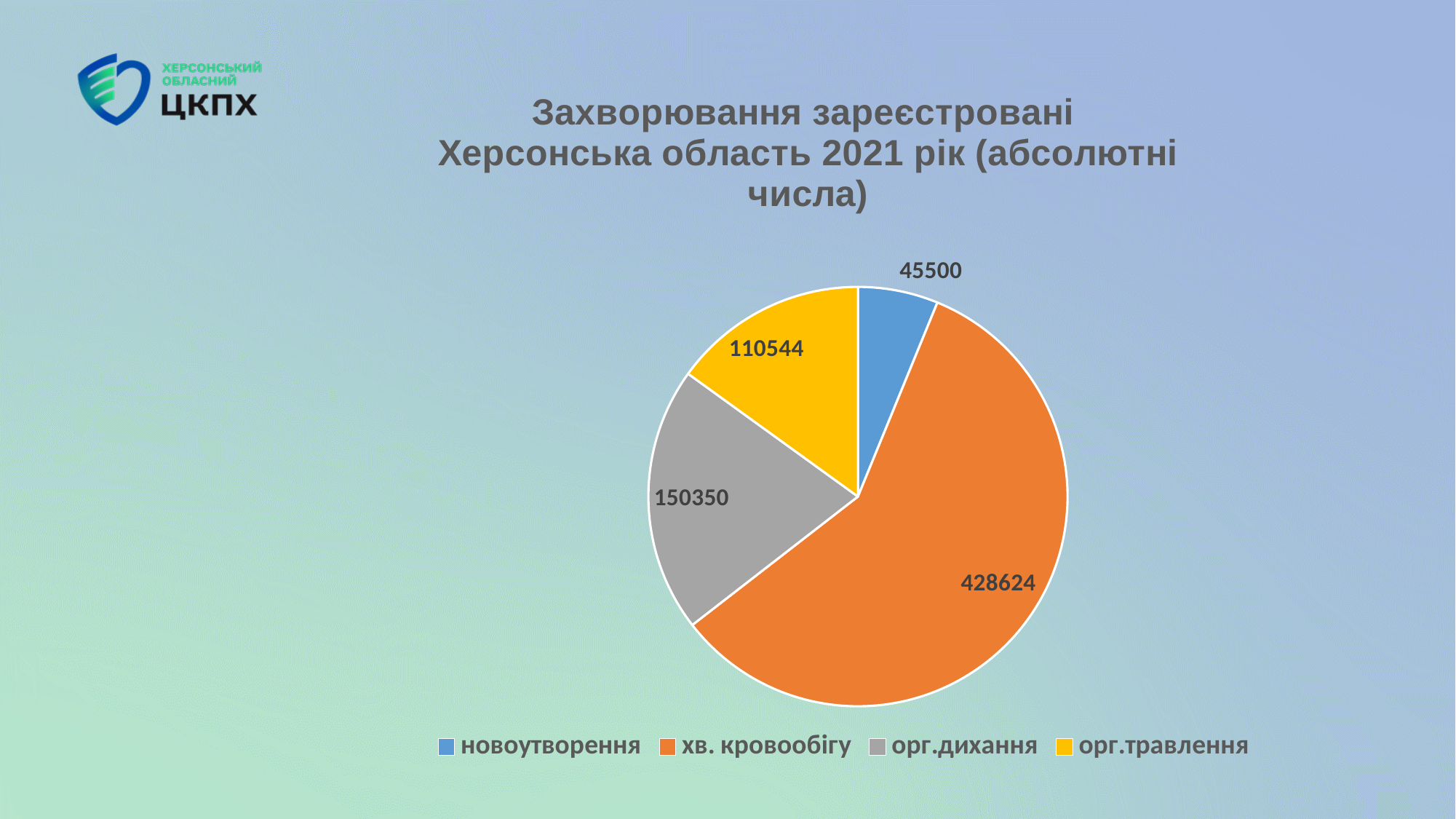
What is the value for новоутворення? 45500 Which category has the largest slice of the pie? хв. кровообігу What is the value for орг.дихання? 150350 What is the difference between the values for орг.дихання and орг.травлення? 39806 What is the value for хв. кровообігу? 428624 What colour is the slice for орг.травлення? yellow How many categories does the pie chart have? 4 What type of chart is shown on the slide? pie chart What is the value for орг.травлення? 110544 Which category has the smallest slice of the pie? новоутворення What is the total of all slices in the pie chart? 735018 Which is larger, the value for орг.дихання or the value for орг.травлення? орг.дихання